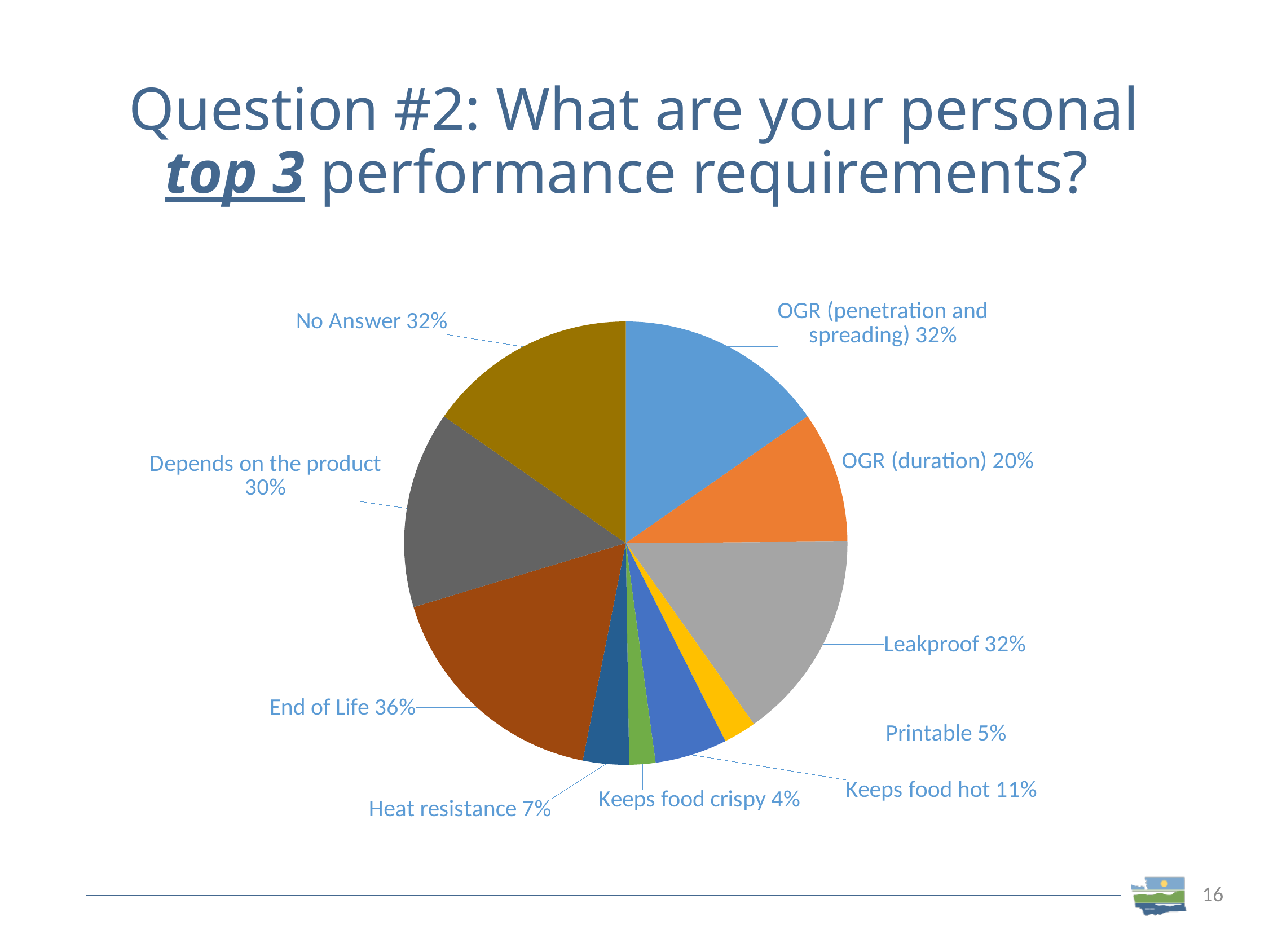
Which is larger, Keeps food hot or Printable? Keeps food hot What percentage is shown for Keeps food hot? 11% Which category has the lowest percentage in the pie chart? Keeps food crispy What percentage is shown for Depends on the product? 30% What is the difference in percentage points between End of Life and OGR (duration)? 16 How many slices does the pie chart have? 10 What percentage is shown for End of Life? 36% What percentage is shown for OGR (duration)? 20% Which category has the highest percentage in the pie chart? End of Life What share of the pie is labelled for Heat resistance? 7% What is the title of the slide containing the chart? Question #2: What are your personal top 3 performance requirements? What kind of chart is shown on the slide? Pie chart